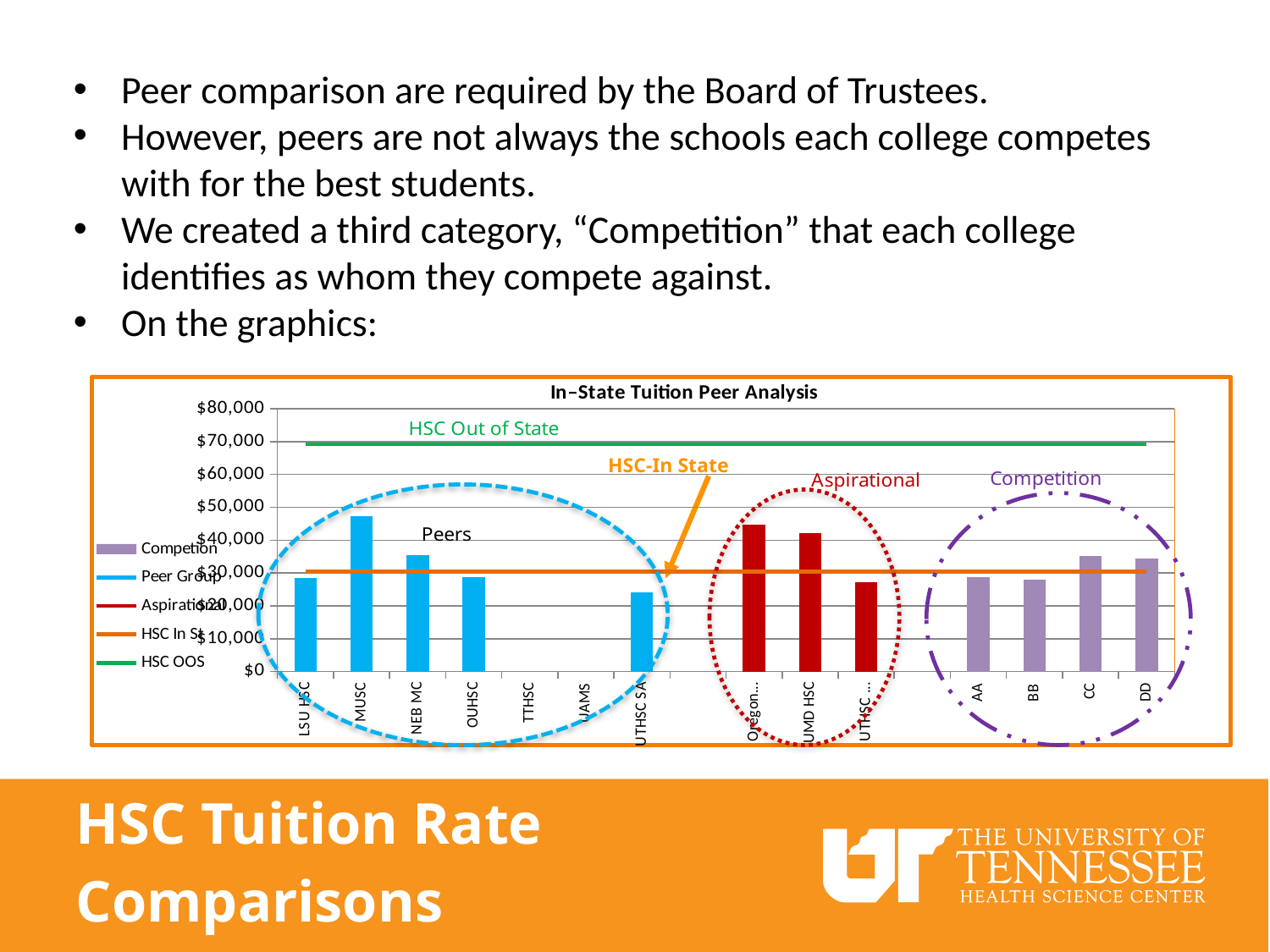
Which is larger, the value for MUSC or the value for NEB MC? MUSC Which category has the tallest bar in the chart? MUSC Is the value for UTHSC SA greater or less than $30,000? less Is the value for CC greater or less than $30,000? greater How many entries does the chart's legend list? 5 What is the title of the chart on the slide? In-State Tuition Peer Analysis What colour are the Peer Group bars in the chart? blue Is the value for LSU HSC greater or less than $30,000? less What kind of chart is shown on the slide? combination bar and line chart